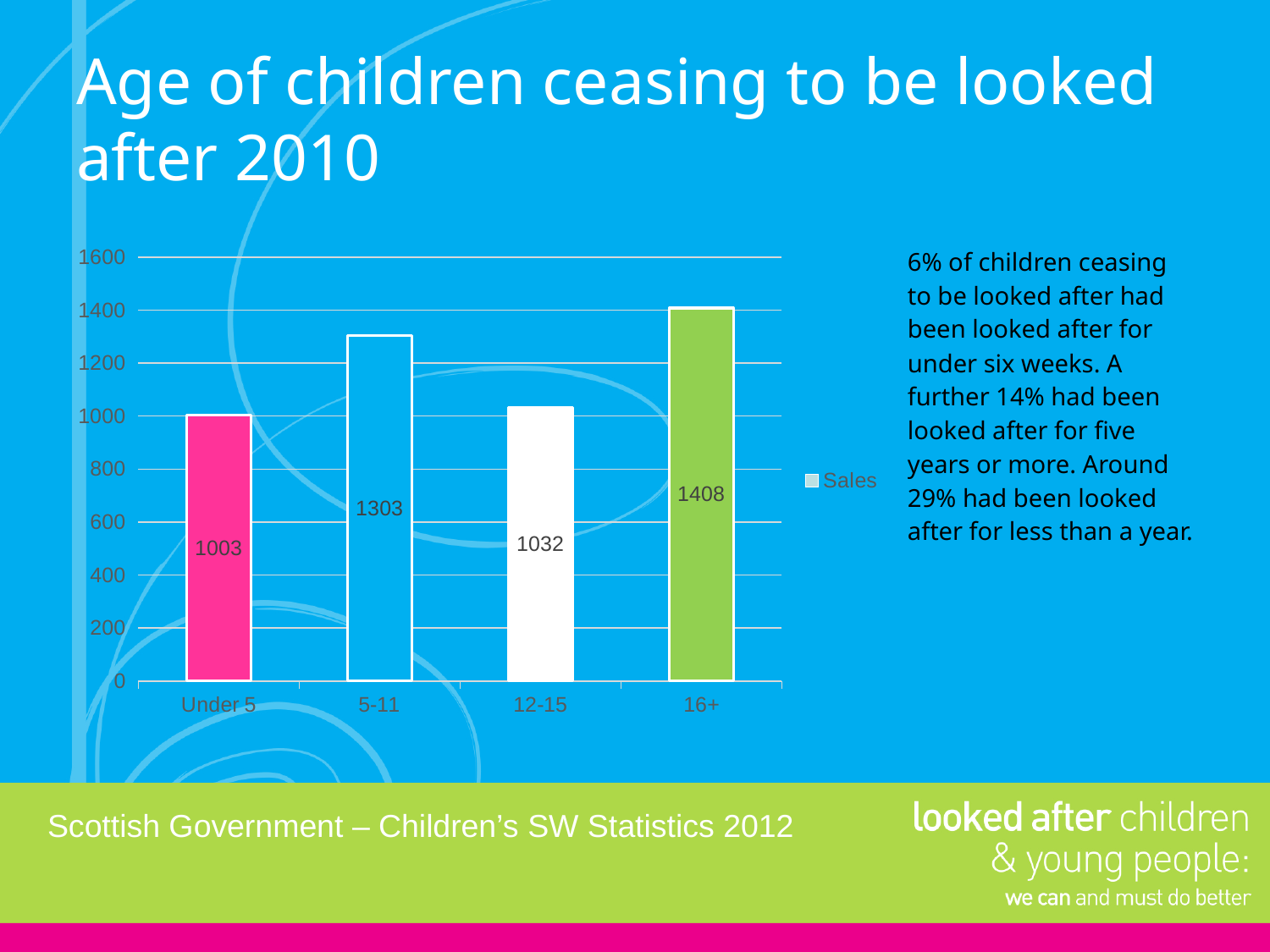
What is the difference between the values for 16+ and 5-11? 105 Which age category has the lowest value? Under 5 Which age category has the highest value? 16+ How many age categories are shown on the x axis? 4 What is the value for the 16+ category? 1408 What is the value for the 5-11 category? 1303 What is the value for the 12-15 category? 1032 What series name does the legend show? Sales What is the value for the Under 5 category? 1003 Which is larger, the value for 5-11 or the value for 12-15? 5-11 What is the difference between the values for 12-15 and Under 5? 29 What kind of chart is shown on the slide? Bar chart